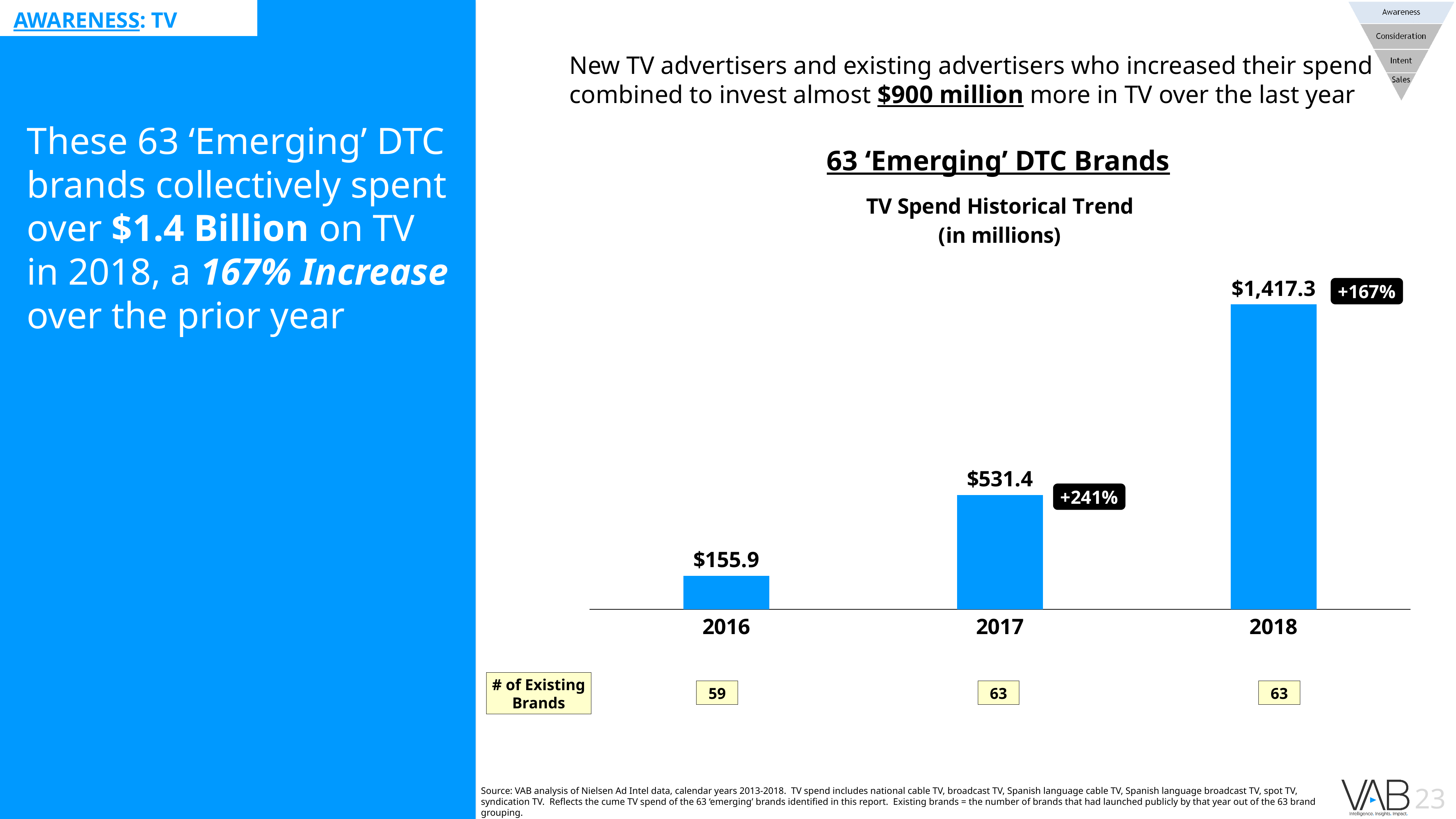
What percentage increase is labelled next to the 2017 bar? +241% Which year has the lowest TV spend in the chart? 2016 What is the TV spend value shown for 2018? $1,417.3 How many years are plotted in the TV Spend Historical Trend chart? 3 What kind of chart is used to show the TV Spend Historical Trend? Bar chart What is the difference in TV spend between 2017 and 2016? $375.5 What is the difference in TV spend between 2018 and 2017? $885.9 What is the TV spend value shown for 2017? $531.4 What is the TV spend value shown for 2016? $155.9 Which year has the larger TV spend, 2016 or 2017? 2017 Do the TV spend values rise or fall from 2016 to 2018? Rise Which year has the highest TV spend in the chart? 2018